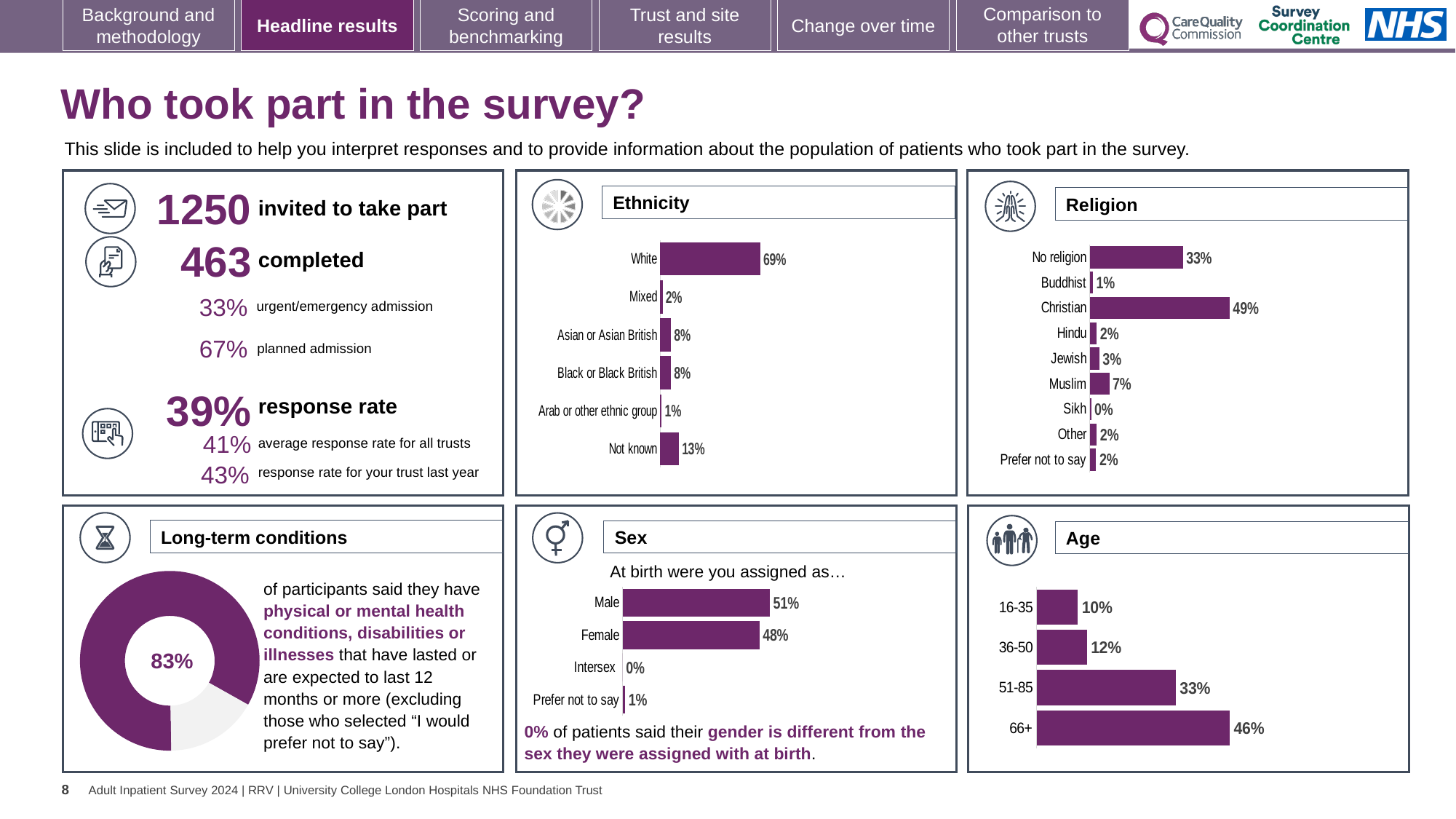
In the Sex chart, what is the difference between the Male and Female values? 3% What kind of chart is used in the Long-term conditions panel? doughnut chart In the Religion chart, which category has the lowest value? Sikh In the Sex chart, what percentage of respondents were Female? 48% In the Religion chart, how many categories are shown? 9 In the Religion chart, what percentage of respondents were Christian? 49% In the Religion chart, which is larger, No religion or Muslim? No religion In the Ethnicity chart, what percentage of respondents were White? 69% In the Ethnicity chart, what is the difference between the White and Not known values? 56% In the Age chart, what percentage of respondents were aged 66+? 46% In the Age chart, do the values rise or fall as age increases from 16-35 to 66+? rise In the Ethnicity chart, which category has the highest value? White